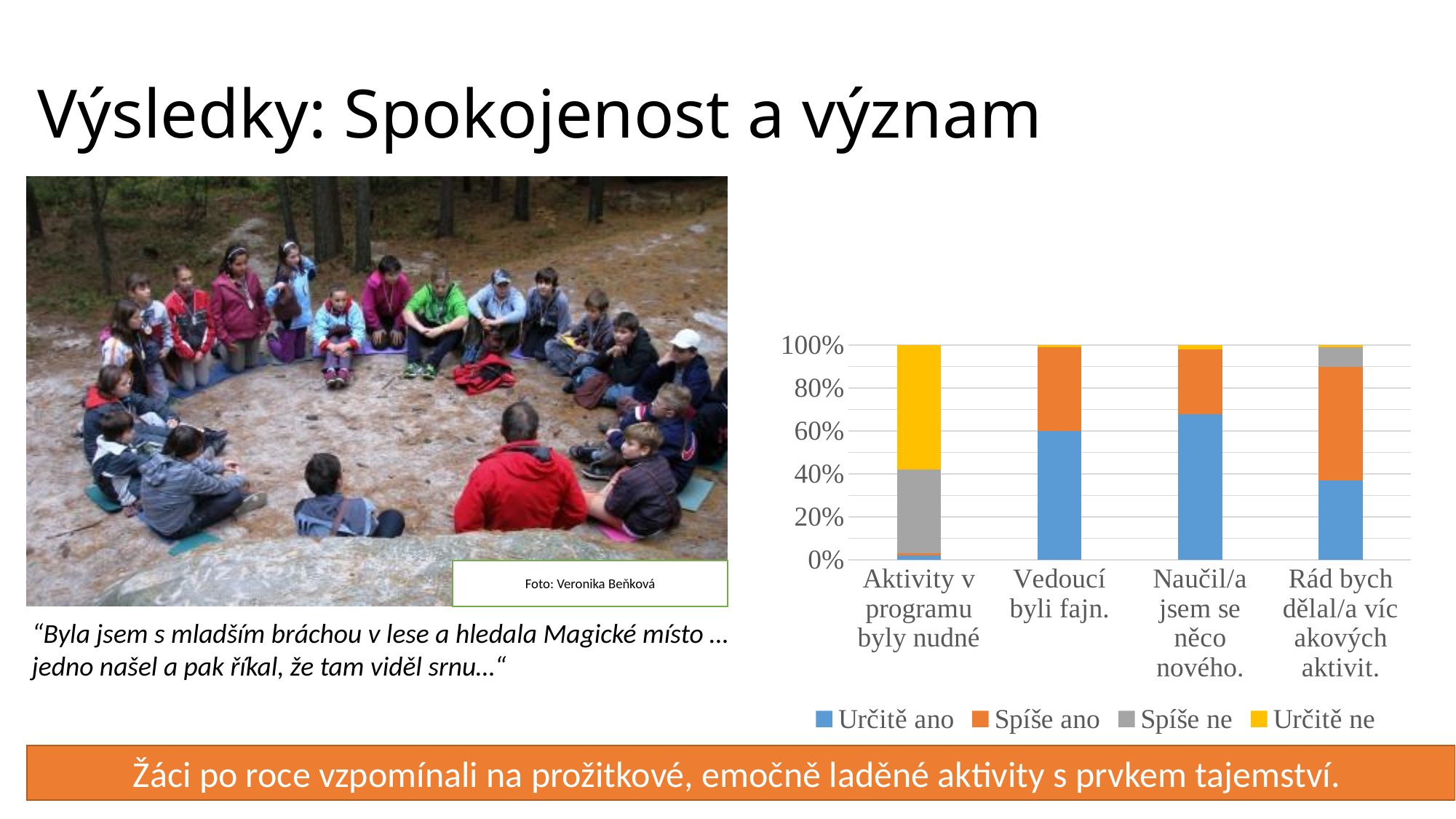
How many series does the chart legend list? 4 How many categories are shown on the x axis of the chart? 4 Is the "Určitě ano" segment larger for "Vedoucí byli fajn." or for "Rád bych dělal/a víc akových aktivit."? Vedoucí byli fajn. Which category has the largest "Určitě ne" segment? Aktivity v programu byly nudné Is the "Určitě ano" value for "Rád bych dělal/a víc akových aktivit." greater or less than 60%? less Is the "Určitě ano" value for "Naučil/a jsem se něco nového." greater or less than 60%? greater What kind of chart is shown on the slide? stacked bar chart Which colour represents the "Určitě ano" series in the chart? blue Which category has the largest "Určitě ano" segment? Naučil/a jsem se něco nového. Which category has the smallest "Určitě ano" segment? Aktivity v programu byly nudné Is the "Určitě ano" value for "Vedoucí byli fajn." greater or less than 40%? greater Which category has the largest "Spíše ne" segment? Aktivity v programu byly nudné